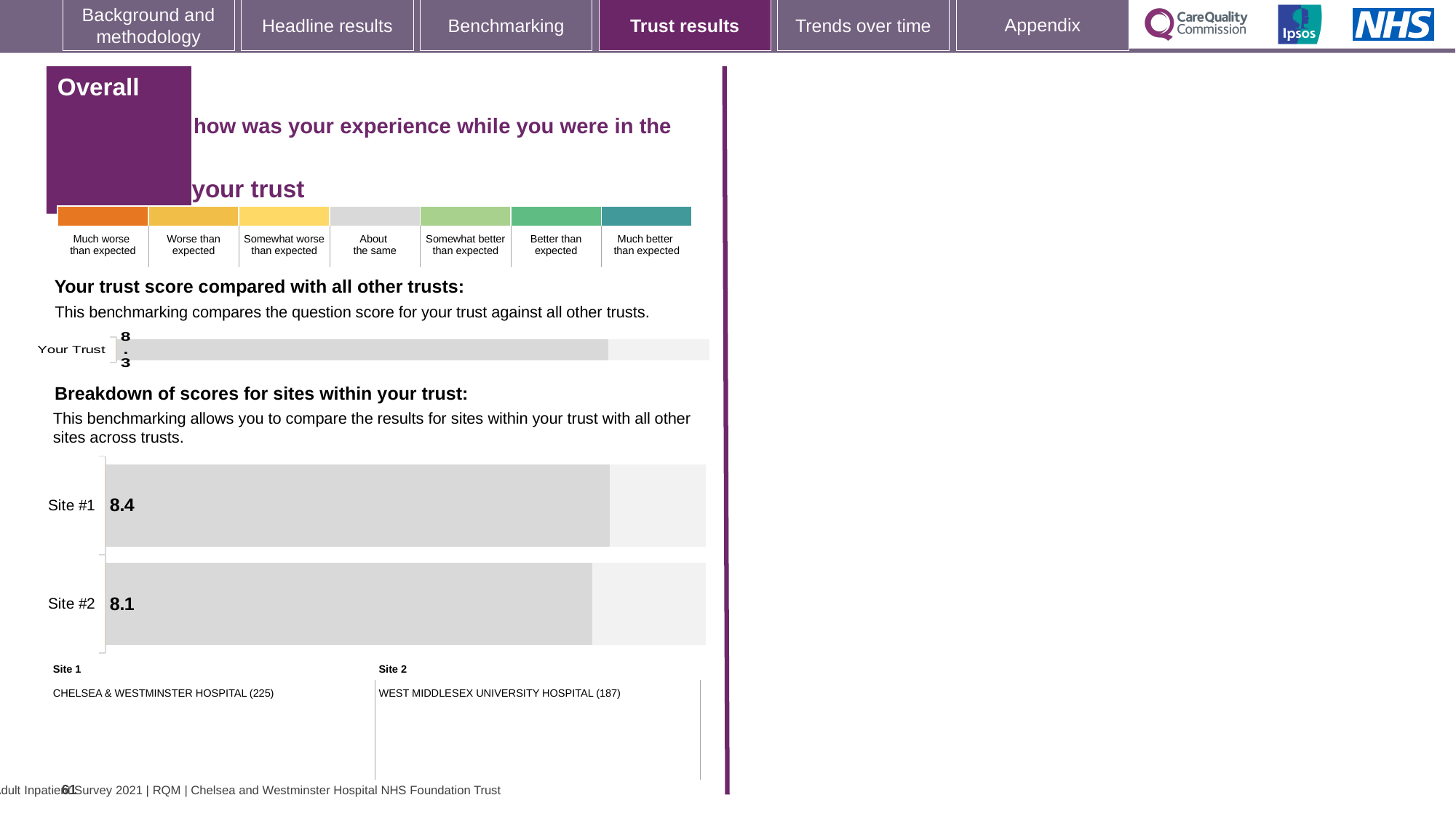
What kind of chart is the 'Breakdown of scores for sites within your trust' chart? Bar chart Which hospital is listed as Site 1 below the 'Breakdown of scores for sites within your trust' chart? CHELSEA & WESTMINSTER HOSPITAL (225) How many sites are shown in the 'Breakdown of scores for sites within your trust' chart? 2 Which hospital is listed as Site 2 below the 'Breakdown of scores for sites within your trust' chart? WEST MIDDLESEX UNIVERSITY HOSPITAL (187) In the 'Breakdown of scores for sites within your trust' chart, which site has the lowest score? Site #2 In the 'Breakdown of scores for sites within your trust' chart, what is the score for Site #1? 8.4 In the 'Breakdown of scores for sites within your trust' chart, what is the difference between the scores for Site #1 and Site #2? 0.3 In the 'Your trust score compared with all other trusts' chart, what is the score shown for Your Trust? 8.3 In the 'Breakdown of scores for sites within your trust' chart, which has the larger score, Site #1 or Site #2? Site #1 In the 'Breakdown of scores for sites within your trust' chart, which site has the highest score? Site #1 How many categories are plotted in the 'Your trust score compared with all other trusts' chart? 1 In the 'Breakdown of scores for sites within your trust' chart, what is the score for Site #2? 8.1